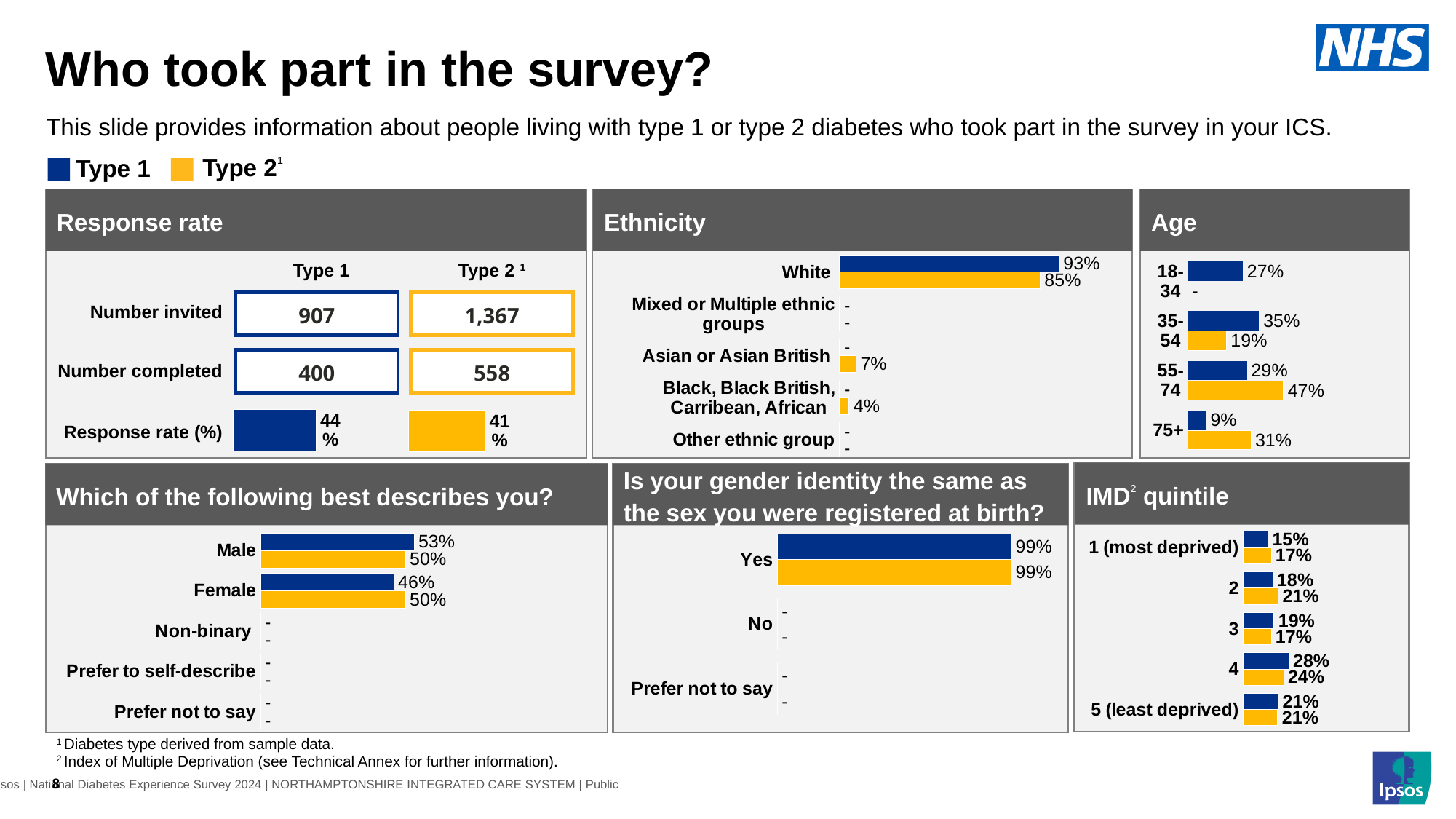
In the 'Which of the following best describes you?' chart, what percentage of Type 1 respondents are Male? 53% In the Ethnicity chart, what percentage of Type 2 respondents are Asian or Asian British? 7% What kind of chart is the Ethnicity chart? Bar chart In the Ethnicity chart, what percentage of Type 1 respondents are White? 93% In the Response rate panel, how many Type 2 people completed the survey? 558 In the Response rate panel, what is the difference between the number of Type 2 and Type 1 people invited? 460 In the Age chart, which age group has the highest Type 2 percentage? 55-74 In the IMD quintile chart, which quintile has the highest Type 1 percentage? 4 In the 'Which of the following best describes you?' chart, is the Type 1 percentage for Male or Female larger? Male In the IMD quintile chart, what is the Type 2 percentage for quintile 2? 21% In the Age chart, which age group has the lowest Type 1 percentage? 75+ In the Age chart, what is the difference between the Type 1 and Type 2 percentages for the 75+ group? 22%